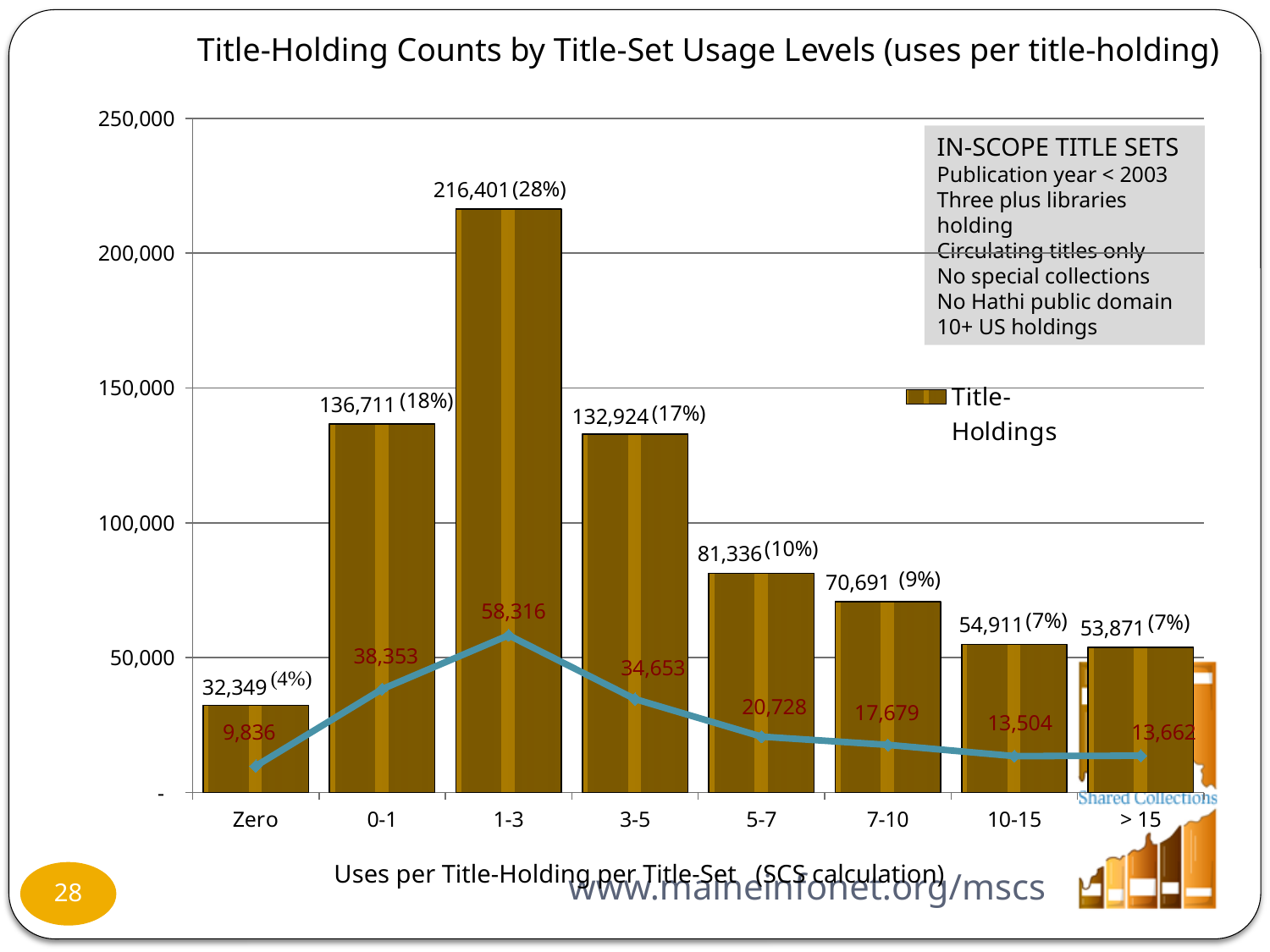
What percentage is shown next to the 5-7 bar? 10% What is the x-axis title of the chart? Uses per Title-Holding per Title-Set (SCS calculation) Which has a larger Title-Holdings value, 5-7 or 7-10? 5-7 What is the Title-Holdings value for the Zero usage level? 32,349 What kind of chart is used to show the Title-Holdings values? bar chart Which usage level has the highest Title-Holdings count? 1-3 How many usage-level categories are shown on the x axis? 8 How many series does the legend list? 1 Which usage level has the lowest Title-Holdings count? Zero What is the Title-Holdings value for the 1-3 usage level? 216,401 What is the difference between the Title-Holdings values for 0-1 and 3-5? 3,787 Is the Title-Holdings value for 10-15 greater or less than 100,000? less